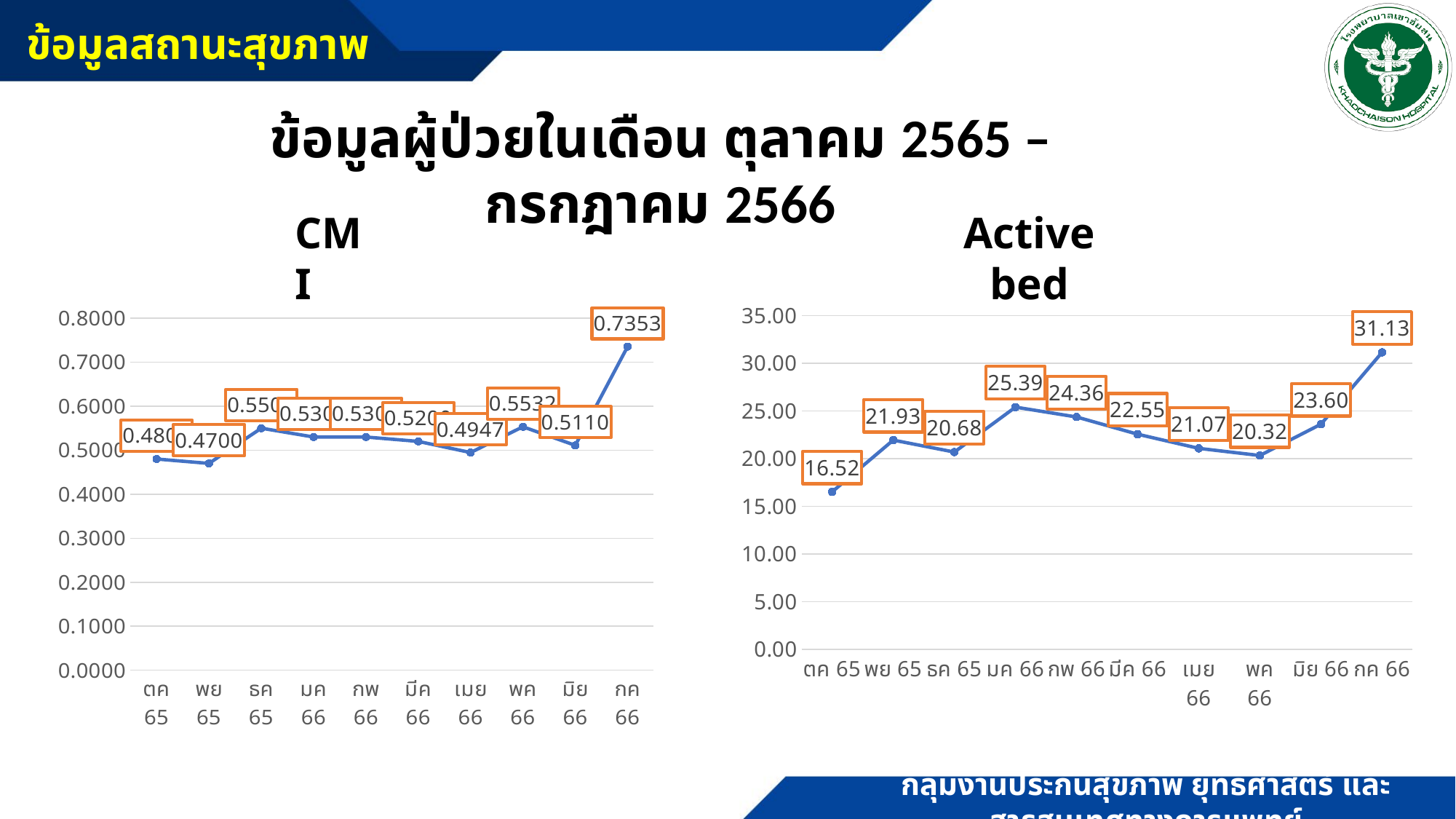
In the CMI chart, which month has the highest value? กค 66 In the Active bed chart, what is the value for กค 66? 31.13 In the Active bed chart, which is larger, the value for พย 65 or the value for พค 66? พย 65 What type of chart is the CMI chart? line chart In the Active bed chart, what is the value for มค 66? 25.39 In the Active bed chart, which month has the lowest value? ตค 65 In the Active bed chart, what is the value for ตค 65? 16.52 In the CMI chart, is the value for มิย 66 greater or less than 0.6000? less In the Active bed chart, what is the difference between the values for กค 66 and ตค 65? 14.61 In the CMI chart, what is the value for เมย 66? 0.4947 How many months are plotted in the Active bed chart? 10 In the CMI chart, what is the value for กค 66? 0.7353